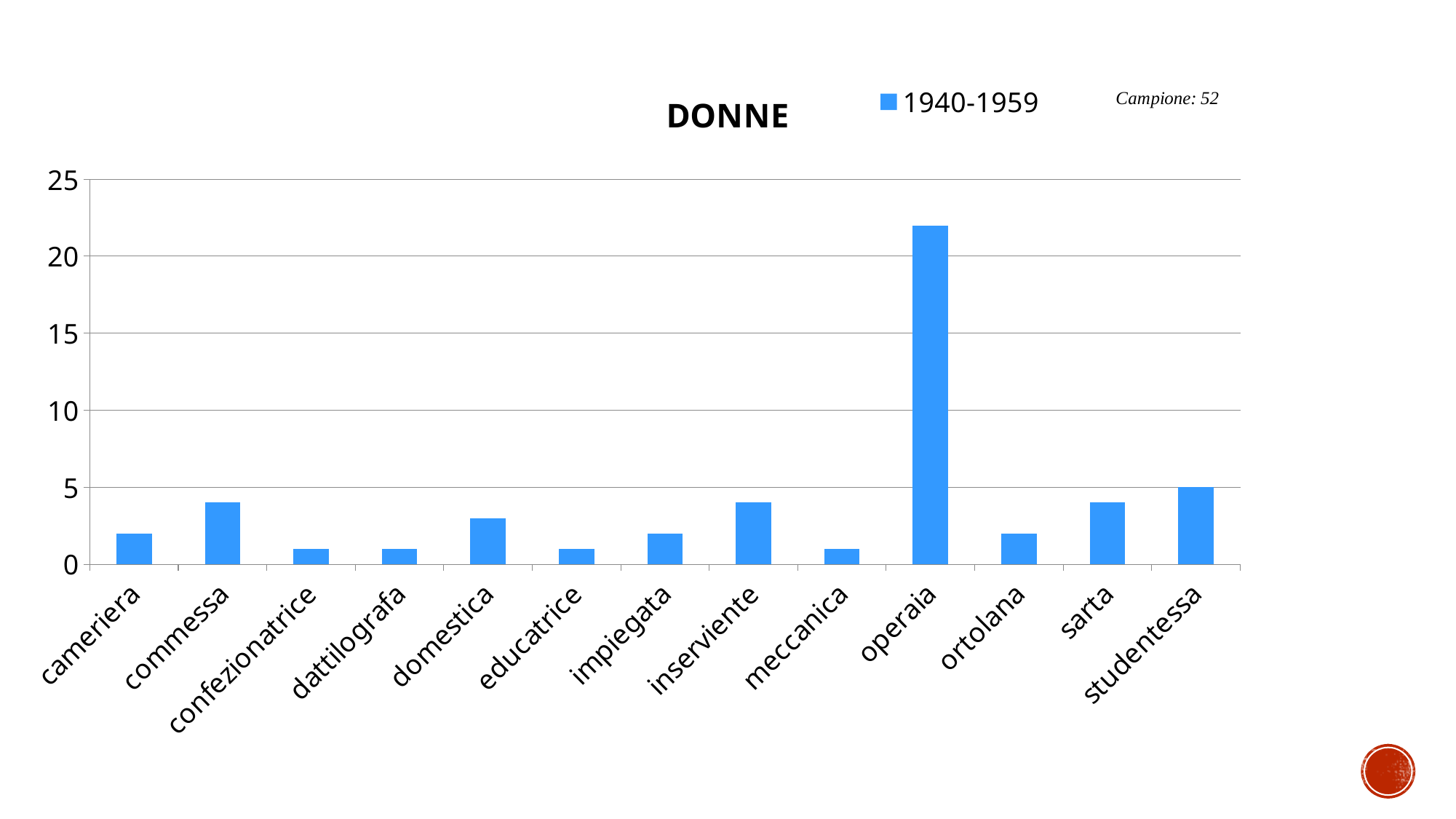
What is the value for studentessa? 5 Which category has the highest value? operaia What series name does the legend show? 1940-1959 Which is larger, the value for commessa or the value for confezionatrice? commessa What kind of chart is shown on the slide? bar chart Is the value for operaia greater or less than 20? greater How many categories are shown on the x axis? 13 Is the value for commessa greater or less than 5? less What is the title of the chart? DONNE How many series does the legend list? 1 Which is larger, the value for operaia or the value for studentessa? operaia Is the value for domestica greater or less than 5? less